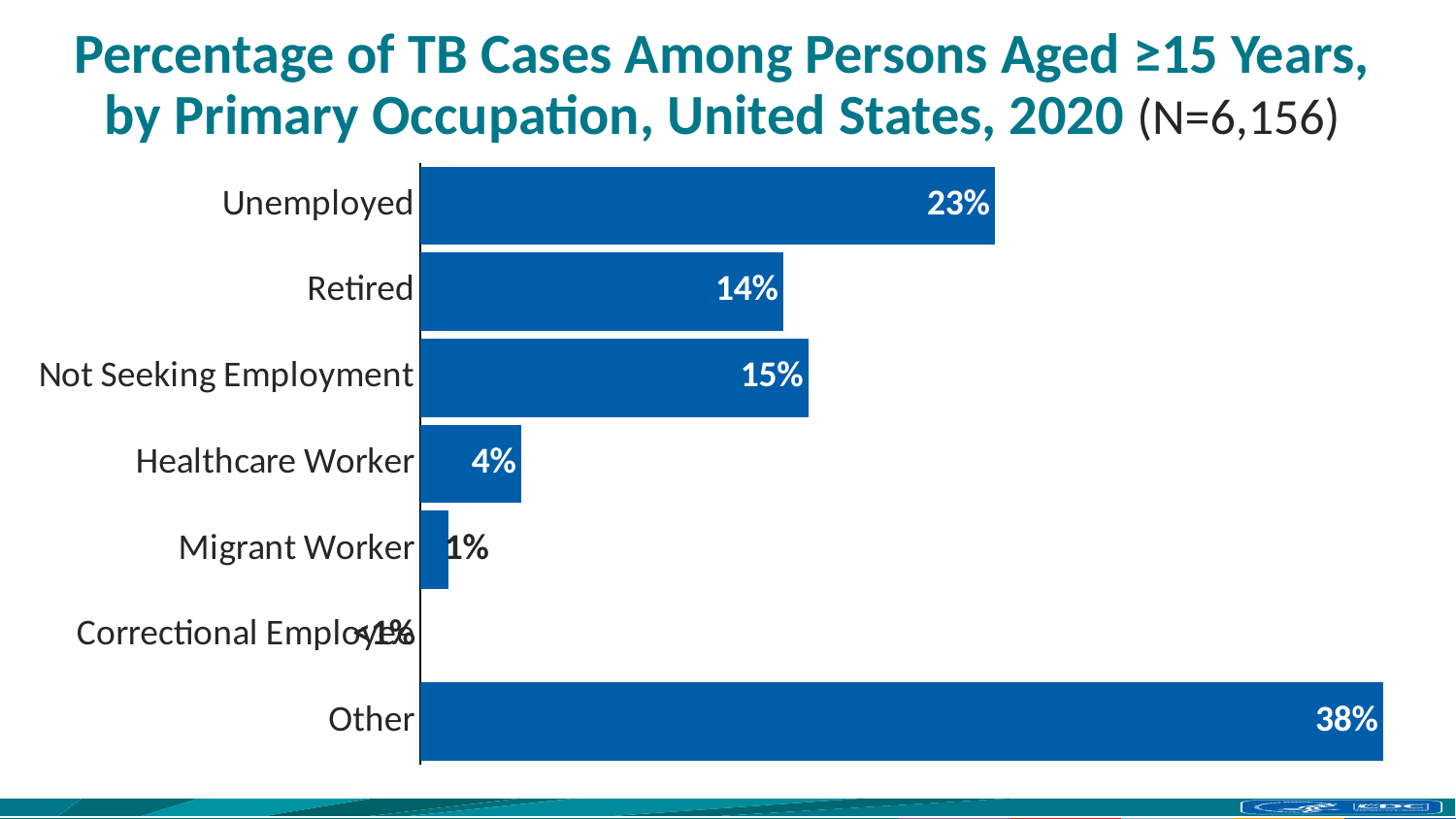
What percentage of TB cases is shown for Migrant Worker? 1% What is the total number of cases (N) stated in the chart title? 6,156 What percentage of TB cases is shown for Unemployed? 23% What is the difference in percentage points between Not Seeking Employment and Retired? 1 What is the difference in percentage points between Other and Unemployed? 15 What value is shown for Correctional Employee? <1% Which has a higher percentage, Retired or Not Seeking Employment? Not Seeking Employment Which occupation category has the highest percentage of TB cases? Other How many occupation categories are shown in the chart? 7 What percentage of TB cases is shown for Healthcare Worker? 4% Which occupation category has the lowest percentage of TB cases? Correctional Employee What kind of chart is shown on the slide? Bar chart